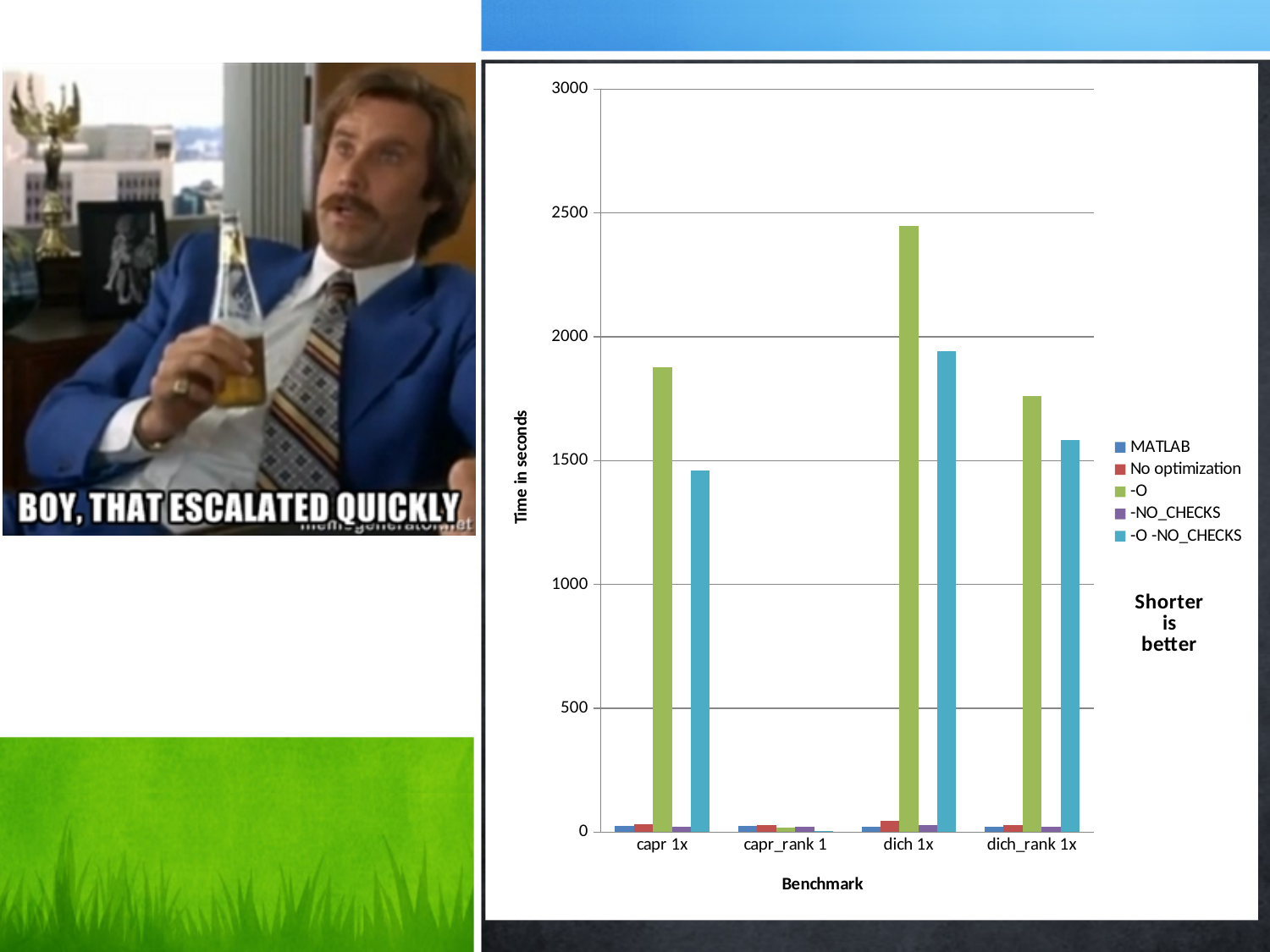
How many benchmarks are shown on the x axis of the chart? 4 Is the -O value for dich 1x greater or less than 2000? greater What is the label of the chart's horizontal axis? Benchmark Is the -O -NO_CHECKS value for dich 1x greater or less than 2000? less Is the -O -NO_CHECKS value for capr 1x greater or less than 1500? less Which benchmark has the tallest -O bar? dich 1x What is the label of the chart's vertical axis? Time in seconds How many series does the chart's legend list? 5 For capr 1x, which is larger: the -O bar or the -O -NO_CHECKS bar? -O Which benchmark has the shortest -O bar? capr_rank 1 What kind of chart is shown on the slide? bar chart